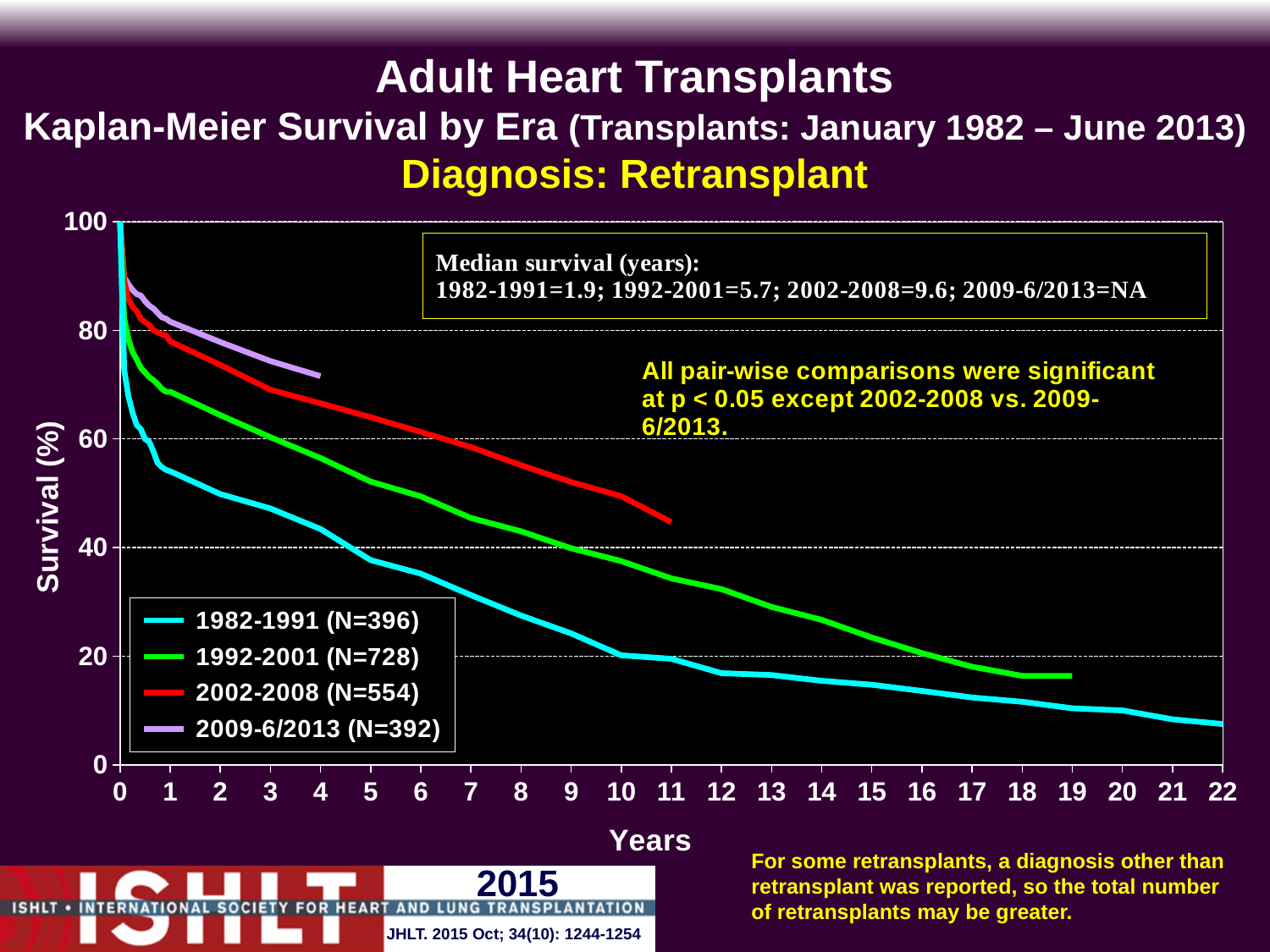
What is the median survival in years for the 2002-2008 era? 9.6 Which era has the lowest median survival? 1982-1991 Do the survival curves rise or fall as years increase? Fall What is the N for the 1992-2001 era in the legend? 728 At 5 years, which era has higher survival: 1992-2001 or 1982-1991? 1992-2001 Is the survival for the 2002-2008 era at 10 years greater or less than 40%? greater What is the median survival in years for the 1982-1991 era? 1.9 What is the difference in median survival (years) between the 2002-2008 era and the 1982-1991 era? 7.7 Is the survival for the 1982-1991 era at 20 years greater or less than 20%? less What is the median survival reported for the 2009-6/2013 era? NA What type of chart is shown on the slide? Line chart How many eras (series) does the legend list? 4